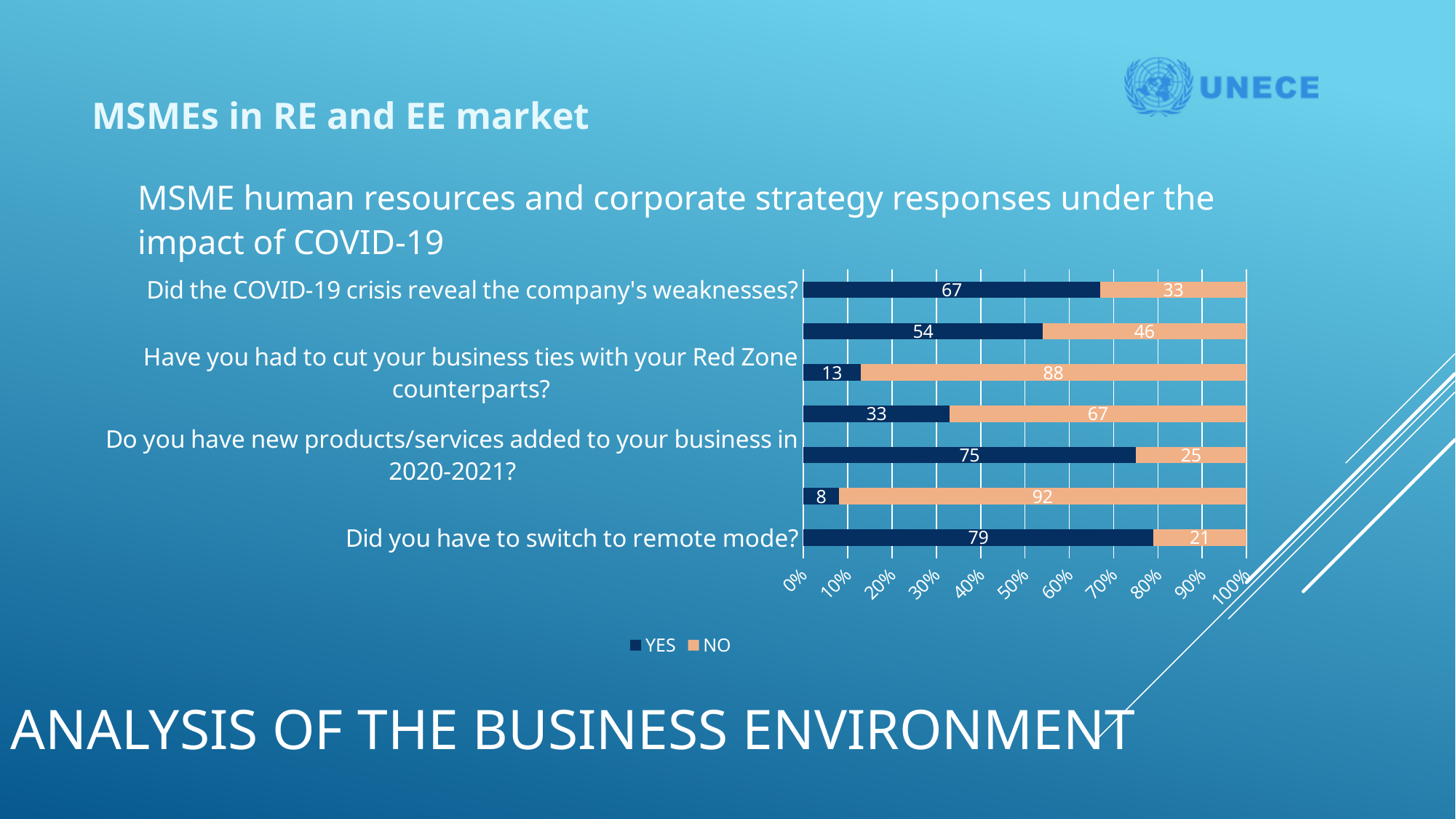
What is the NO value for "Did you have to switch to remote mode?"? 21 What is the NO value for "Have you had to cut your business ties with your Red Zone counterparts?"? 88 What is the difference between the YES and NO values for "Did the COVID-19 crisis reveal the company's weaknesses?"? 34 Which is larger for "Did you have to switch to remote mode?": the YES value or the NO value? YES How many bars are plotted in the chart? 7 What kind of chart is shown on the slide? Stacked bar chart What is the YES value for "Did the COVID-19 crisis reveal the company's weaknesses?"? 67 Among the labelled questions, which has the lowest YES value? Have you had to cut your business ties with your Red Zone counterparts? Among the labelled questions, which has the highest YES value? Did you have to switch to remote mode? What is the YES value for "Do you have new products/services added to your business in 2020-2021?"? 75 What are the two series named in the legend? YES and NO How many series does the legend list? 2